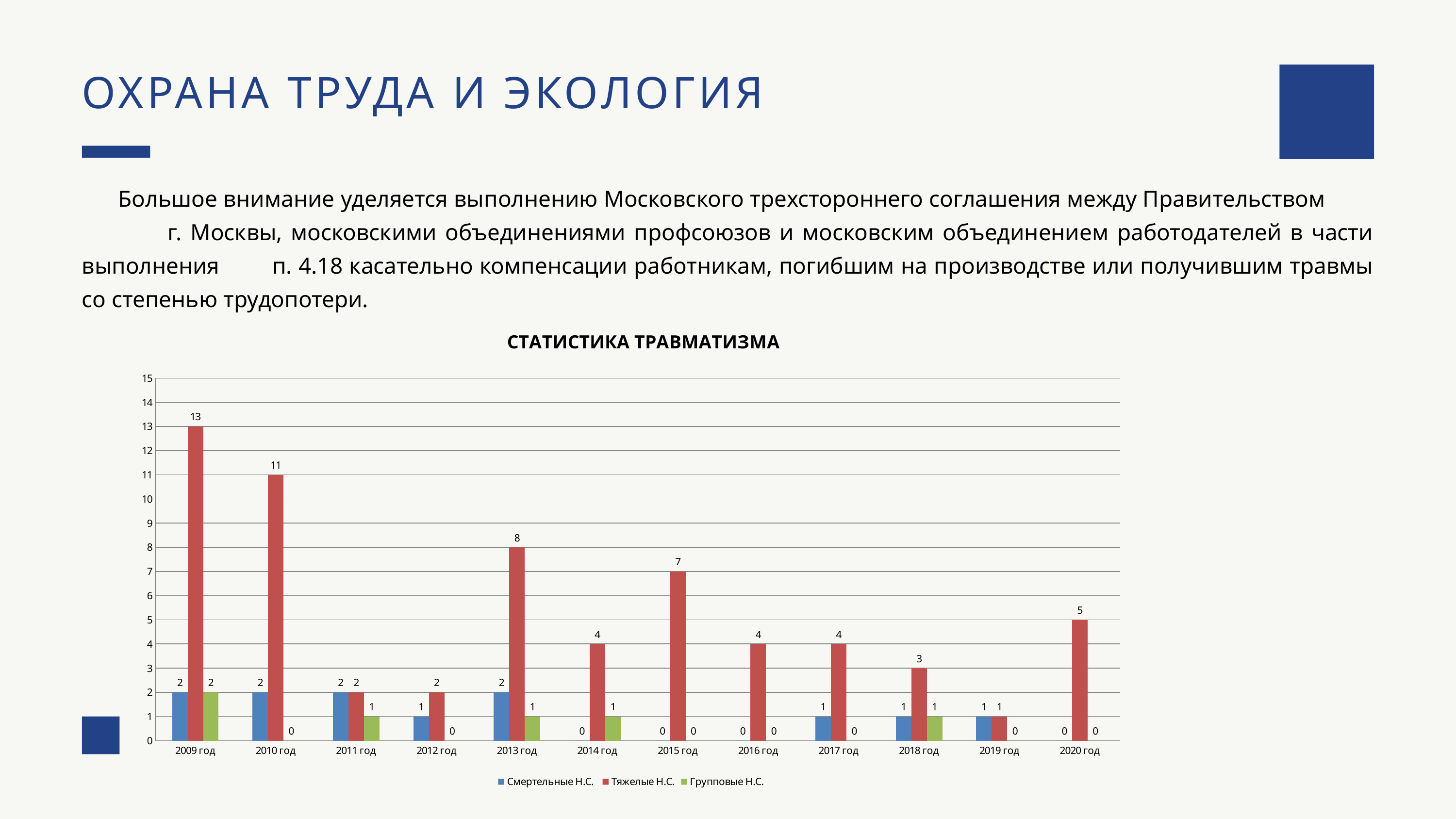
In which year is the value for Тяжелые Н.С. lowest? 2019 год What is the value for Тяжелые Н.С. in 2020 год? 5 How many series does the legend list? 3 What is the title of the chart? СТАТИСТИКА ТРАВМАТИЗМА What is the value for Смертельные Н.С. in 2013 год? 2 Which is larger: Тяжелые Н.С. in 2013 год or Тяжелые Н.С. in 2015 год? 2013 год How many years are shown on the x axis? 12 What kind of chart is shown on the slide? Bar chart In which year is the value for Тяжелые Н.С. highest? 2009 год What is the difference between the Тяжелые Н.С. values for 2009 год and 2010 год? 2 What is the value for Групповые Н.С. in 2018 год? 1 What is the value for Тяжелые Н.С. in 2009 год? 13